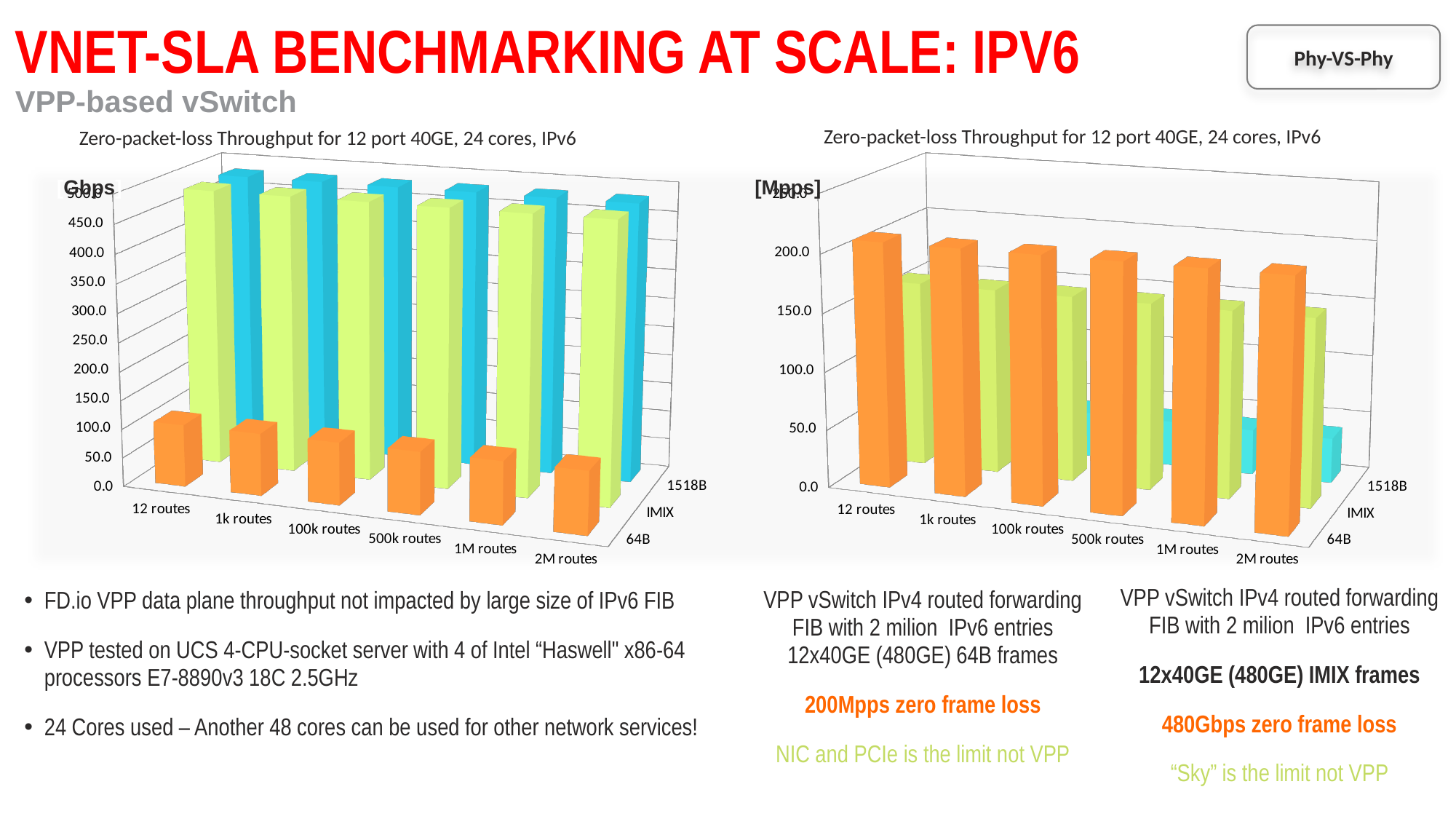
What kind of chart is the left chart on the slide? bar chart In the right chart (Mpps), is the value for 1518B at 2M routes greater or less than 100? less In the left chart (Gbps), do the 64B values rise or fall as the number of routes increases from 12 routes to 2M routes? Neither; they stay the same (flat) What unit is shown on the vertical axis of the right chart? Mpps In the left chart (Gbps), is the value for IMIX at 12 routes greater or less than 400? greater In the left chart (Gbps), which is larger at 12 routes: 64B or IMIX? IMIX In the left chart (Gbps), is the value for 64B at 12 routes greater or less than 200? less How many route-count categories are shown along the x axis of the left chart? 6 How many series (frame sizes) are plotted in the right chart? 3 In the right chart (Mpps), which frame size has the lowest throughput across the route counts? 1518B What is the title of the right chart? Zero-packet-loss Throughput for 12 port 40GE, 24 cores, IPv6